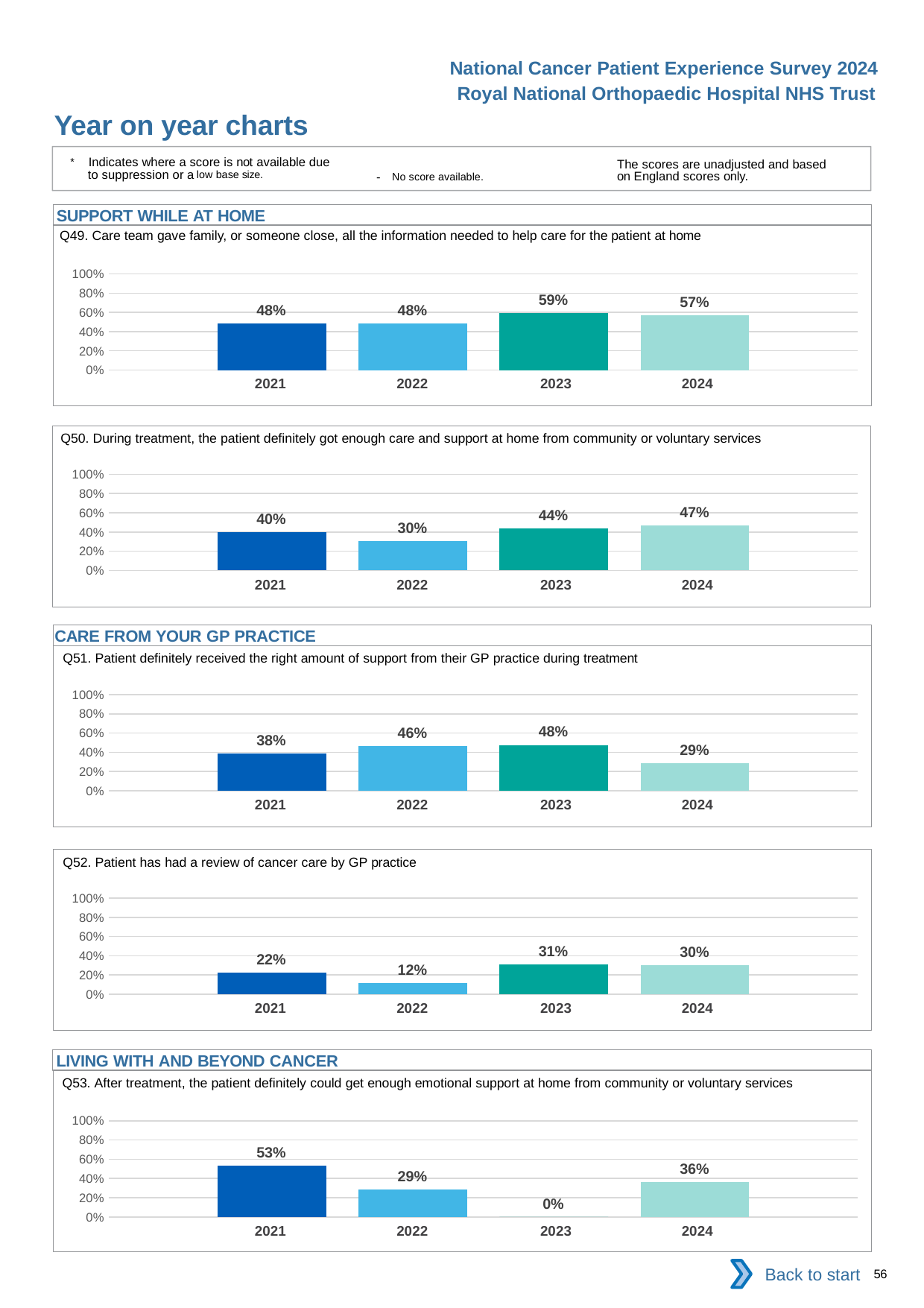
In the Q50 chart, what is the difference between the 2024 and 2021 values? 7% In the Q51 chart, is the value for 2023 larger than the value for 2021? Yes What kind of chart is the Q52 chart? Bar chart In the Q49 chart, which year has the highest value? 2023 In the Q51 chart, which year has the lowest value? 2024 In the Q49 chart, what is the value for 2023? 59% In the Q52 chart, what is the value for 2022? 12% In the Q53 chart, which year has the highest value? 2021 How many years are shown in the Q49 chart? 4 In the Q50 chart, what is the value for 2022? 30% In the Q53 chart, what is the value for 2023? 0% In the Q52 chart, what is the difference between the 2023 and 2022 values? 19%